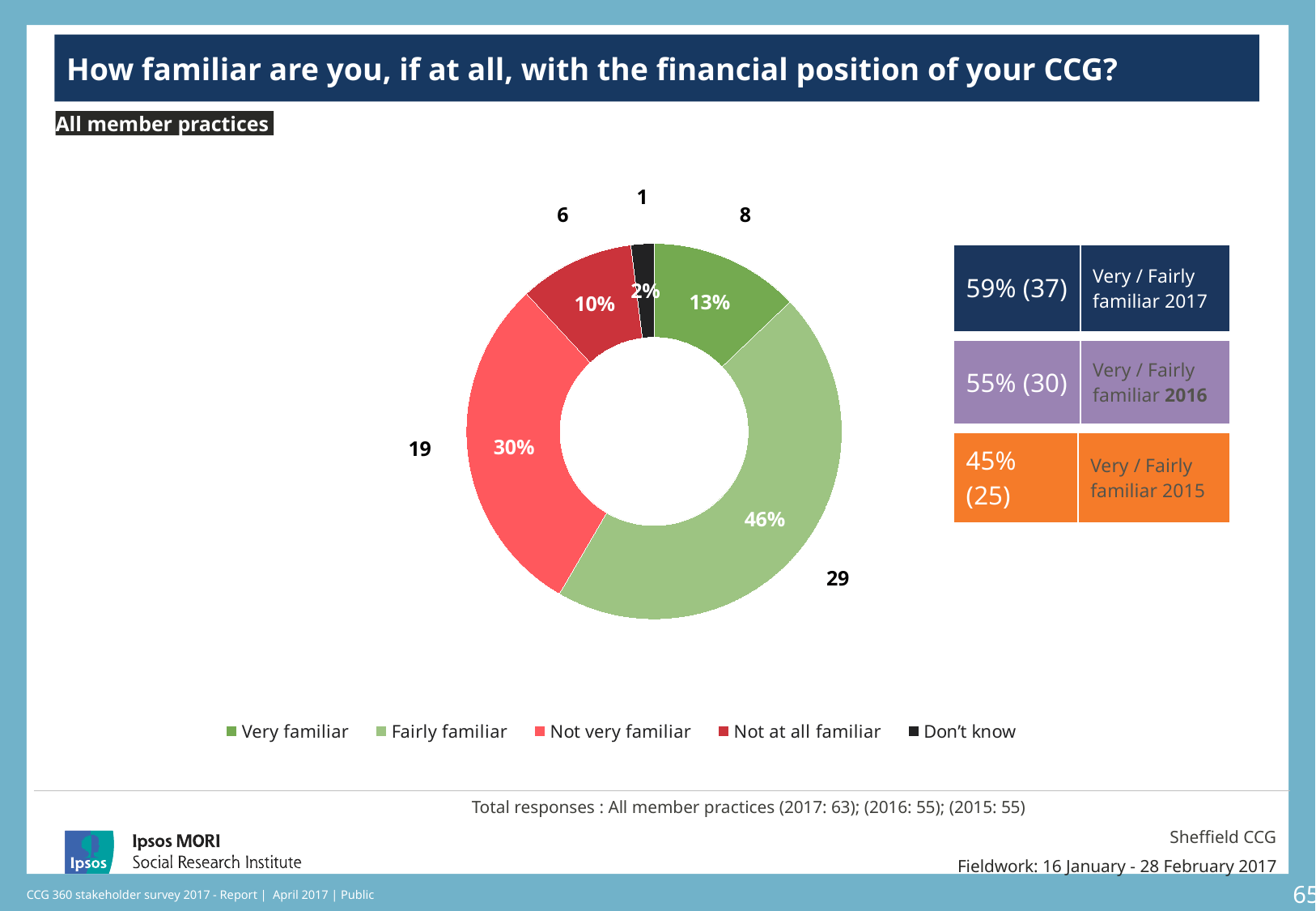
What is the difference in percentage points between 'Fairly familiar' and 'Not very familiar'? 16 What colour represents 'Not very familiar' in the chart? Light red / coral How many respondents answered 'Very familiar'? 8 How many respondents answered 'Not at all familiar'? 6 What percentage of respondents are 'Not very familiar'? 30% What percentage of respondents are 'Fairly familiar' with the financial position of their CCG? 46% How many response categories are shown in the chart? 5 What type of chart is used on this slide? Donut (pie) chart Which is larger: the share for 'Very familiar' or the share for 'Not at all familiar'? Very familiar Which response category has the smallest share of the chart? Don't know Which response category has the largest share of the chart? Fairly familiar What percentage of respondents answered 'Don't know'? 2%